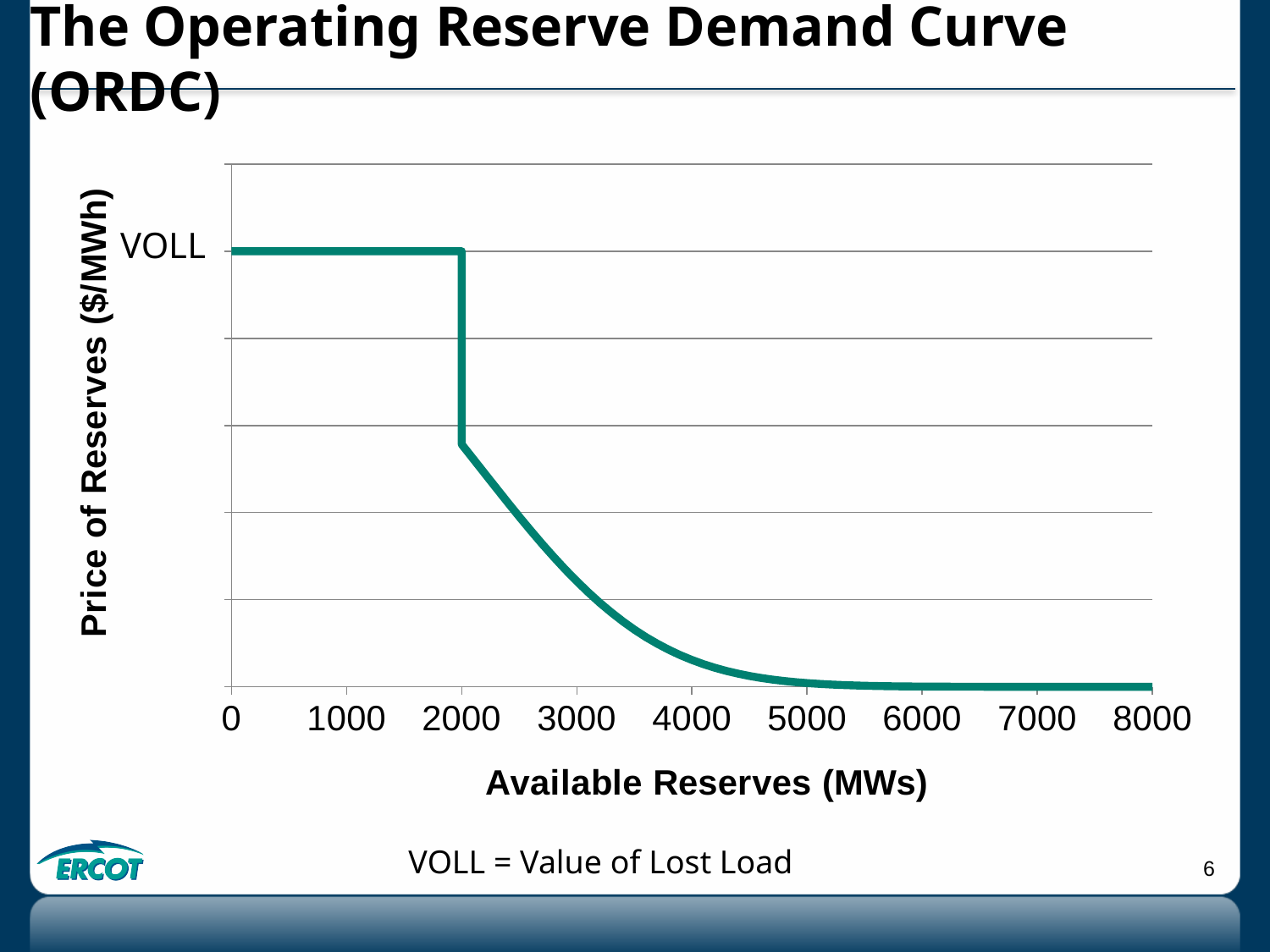
According to the slide, what does VOLL stand for? Value of Lost Load Is the price of reserves higher at 1000 MWs or at 3000 MWs of available reserves? 1000 MWs What is the label of the y axis? Price of Reserves ($/MWh) At what level of available reserves does the curve drop sharply from VOLL? 2000 Is the price of reserves higher at 3000 MWs or at 6000 MWs of available reserves? 3000 MWs What kind of chart is shown on the slide? Line chart Does the price of reserves rise or fall as available reserves increase beyond 2000 MWs? Fall What is the highest value shown on the x axis? 8000 At what level of available reserves is the price of reserves highest? 0 to 2000 MWs (VOLL) What is the price of reserves when available reserves are between 0 and 2000 MWs? VOLL